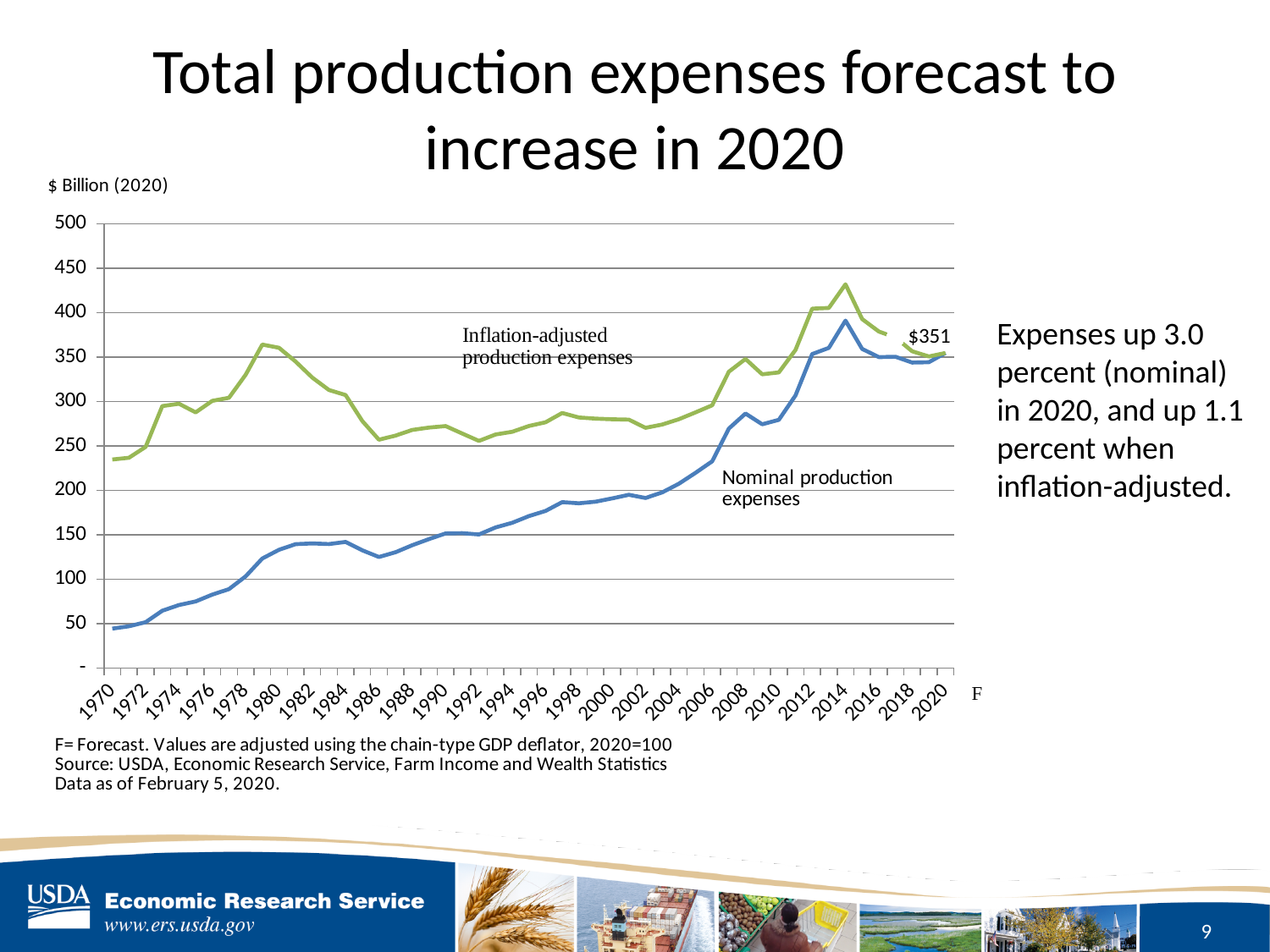
What unit is shown on the y-axis of the chart? $ Billion (2020) What is the title of the chart on the slide? Total production expenses forecast to increase in 2020 Is the value for nominal production expenses in 2008 greater or less than 250? greater What type of chart is shown on the slide? line chart In which year does the inflation-adjusted production expenses line reach its highest point? 2014 Do nominal production expenses generally rise or fall from 1970 to 2014? rise In which year is the nominal production expenses line at its lowest? 1970 How many data series are plotted on the chart? 2 In 1980, which series has the higher value: inflation-adjusted production expenses or nominal production expenses? Inflation-adjusted production expenses Is the value for inflation-adjusted production expenses in 1970 greater or less than 250? less Is the value for inflation-adjusted production expenses in 2014 greater or less than 400? greater What value is labeled at the end of the lines for 2020? $351